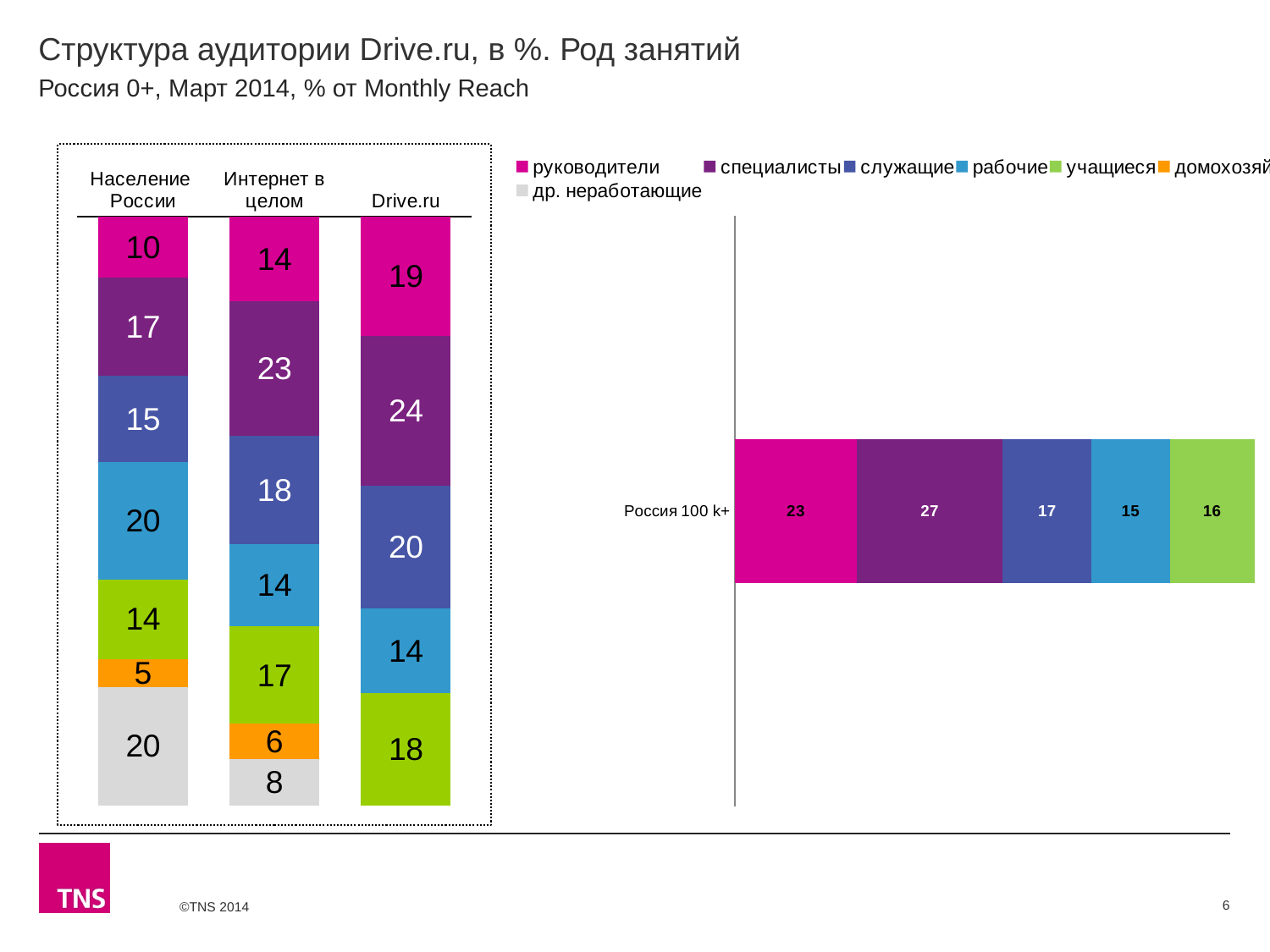
In the left chart, what is the value for специалисты (purple segment) for Интернет в целом? 23 What type of chart is the right chart? Stacked bar chart In the left chart, which is larger: the учащиеся (green) value for Drive.ru or for Население России? Drive.ru How many series does the legend list? 7 In the left chart, what is the difference between the специалисты values for Drive.ru and Население России? 7 In the left chart, what is the value for руководители (pink segment) for Drive.ru? 19 In the left chart, which of the three bars has the highest value for руководители (pink segment)? Drive.ru How many bars (categories) are shown in the left chart? 3 In the right chart, which segment of the Россия 100 k+ bar has the highest value? специалисты In the right chart, which segment of the Россия 100 k+ bar has the lowest value? рабочие In the left chart, what is the value for др. неработающие (grey segment) for Население России? 20 In the right chart, what is the value for специалисты (purple segment) for Россия 100 k+? 27